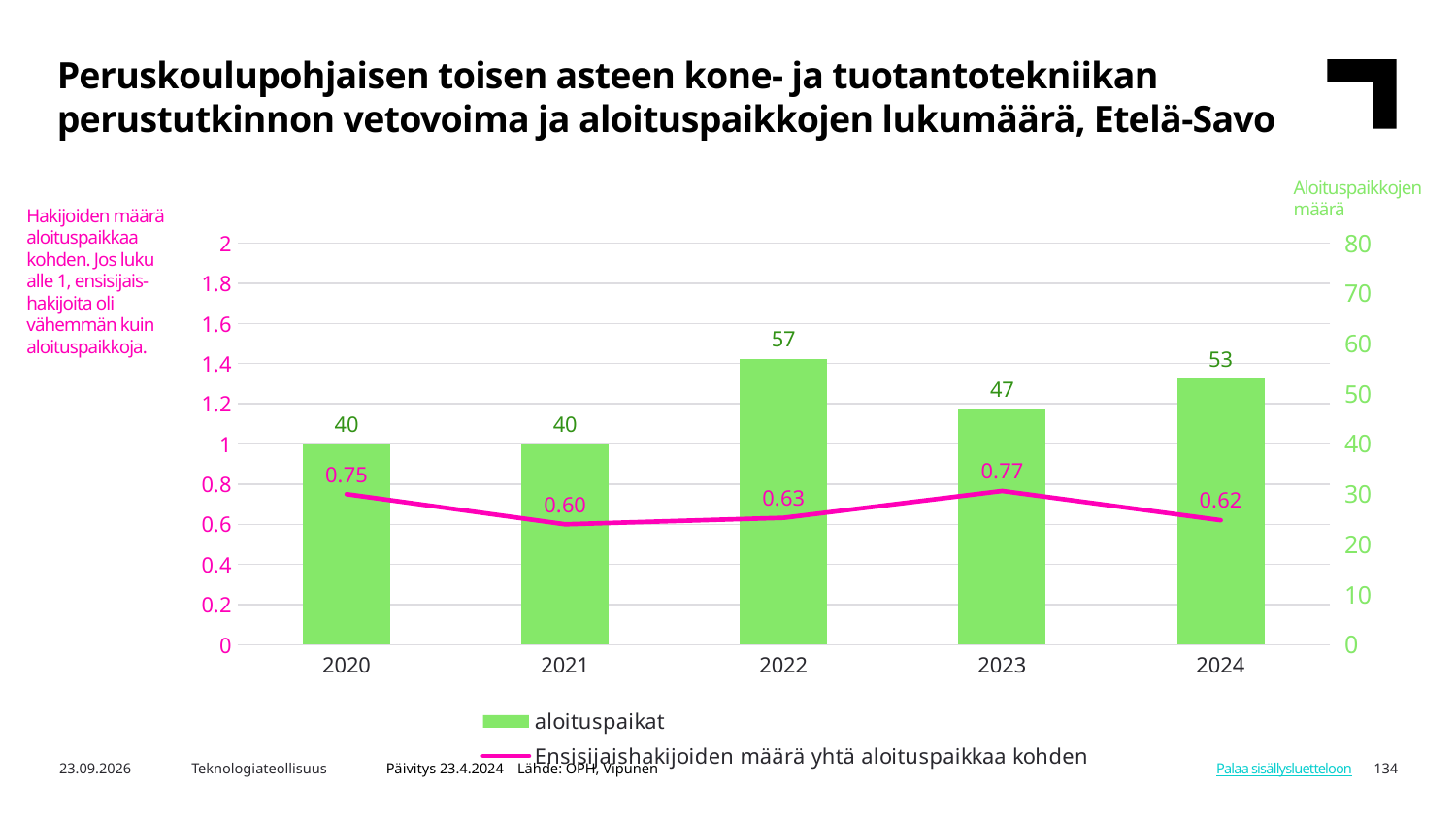
Which year has the larger value of aloituspaikat, 2023 or 2024? 2024 Which year has the highest value of aloituspaikat? 2022 What colour are the aloituspaikat bars? Green How many series does the legend list? 2 What is the difference in aloituspaikat between 2022 and 2023? 10 What kinds of chart are combined on this slide? Bar chart and line chart What is the value of Ensisijaishakijoiden määrä yhtä aloituspaikkaa kohden for 2023? 0.77 What is the value of aloituspaikat for 2022? 57 How many years are shown on the x axis? 5 What is the value of aloituspaikat for 2024? 53 Does the value of Ensisijaishakijoiden määrä yhtä aloituspaikkaa kohden rise or fall from 2020 to 2021? Fall Which year has the lowest value of Ensisijaishakijoiden määrä yhtä aloituspaikkaa kohden? 2021